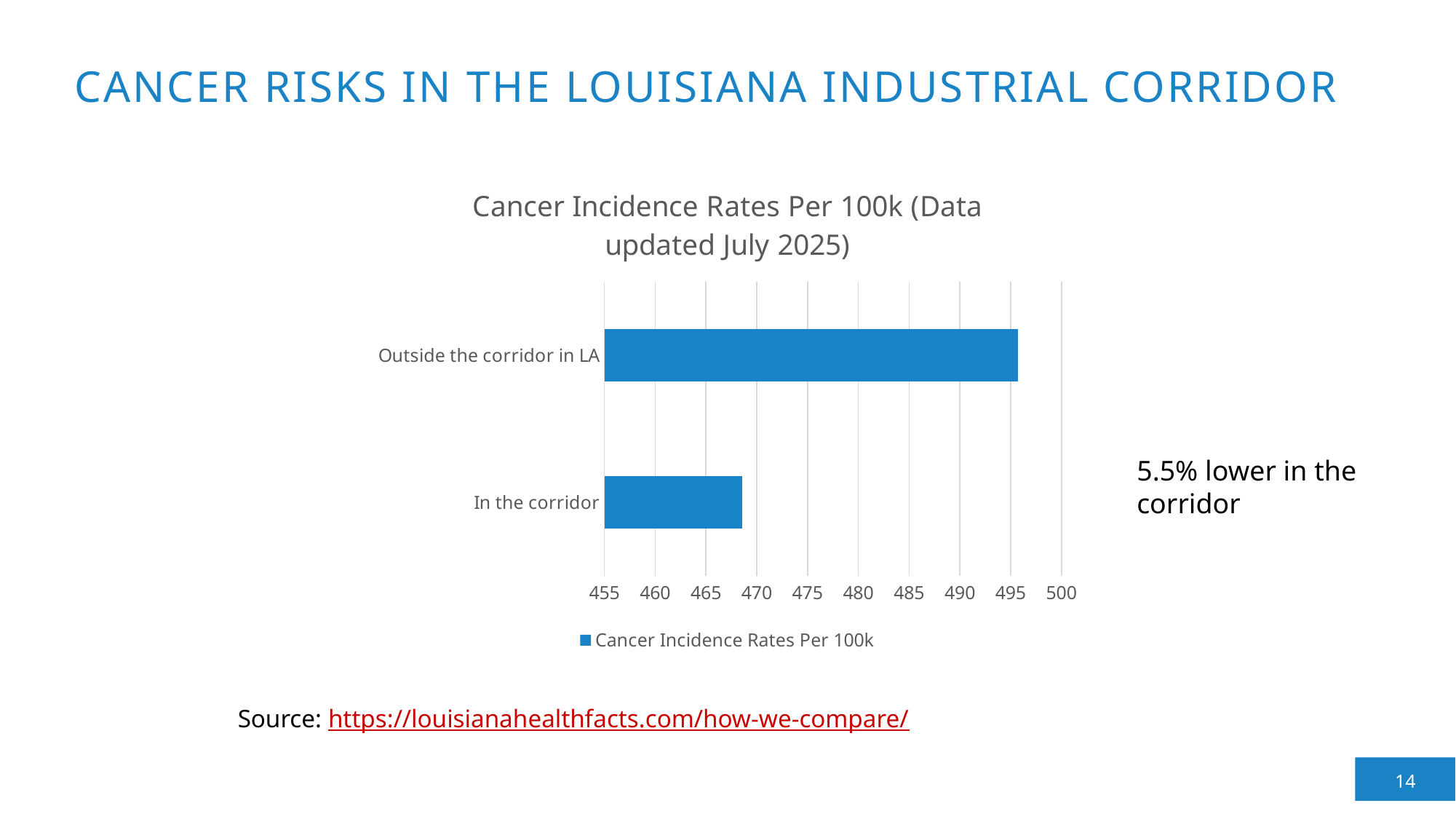
Is the value for In the corridor greater or less than 465? greater How many categories does the chart show? 2 Which is larger, the cancer incidence rate in the corridor or outside the corridor in LA? Outside the corridor in LA What series name is shown in the chart legend? Cancer Incidence Rates Per 100k How many series does the legend list? 1 Is the value for In the corridor greater or less than 470? less What type of chart is shown on the slide? bar chart Is the value for Outside the corridor in LA greater or less than 500? less Which category has the lowest cancer incidence rate per 100k? In the corridor What is the title of the chart? Cancer Incidence Rates Per 100k (Data updated July 2025) Which category has the highest cancer incidence rate per 100k? Outside the corridor in LA